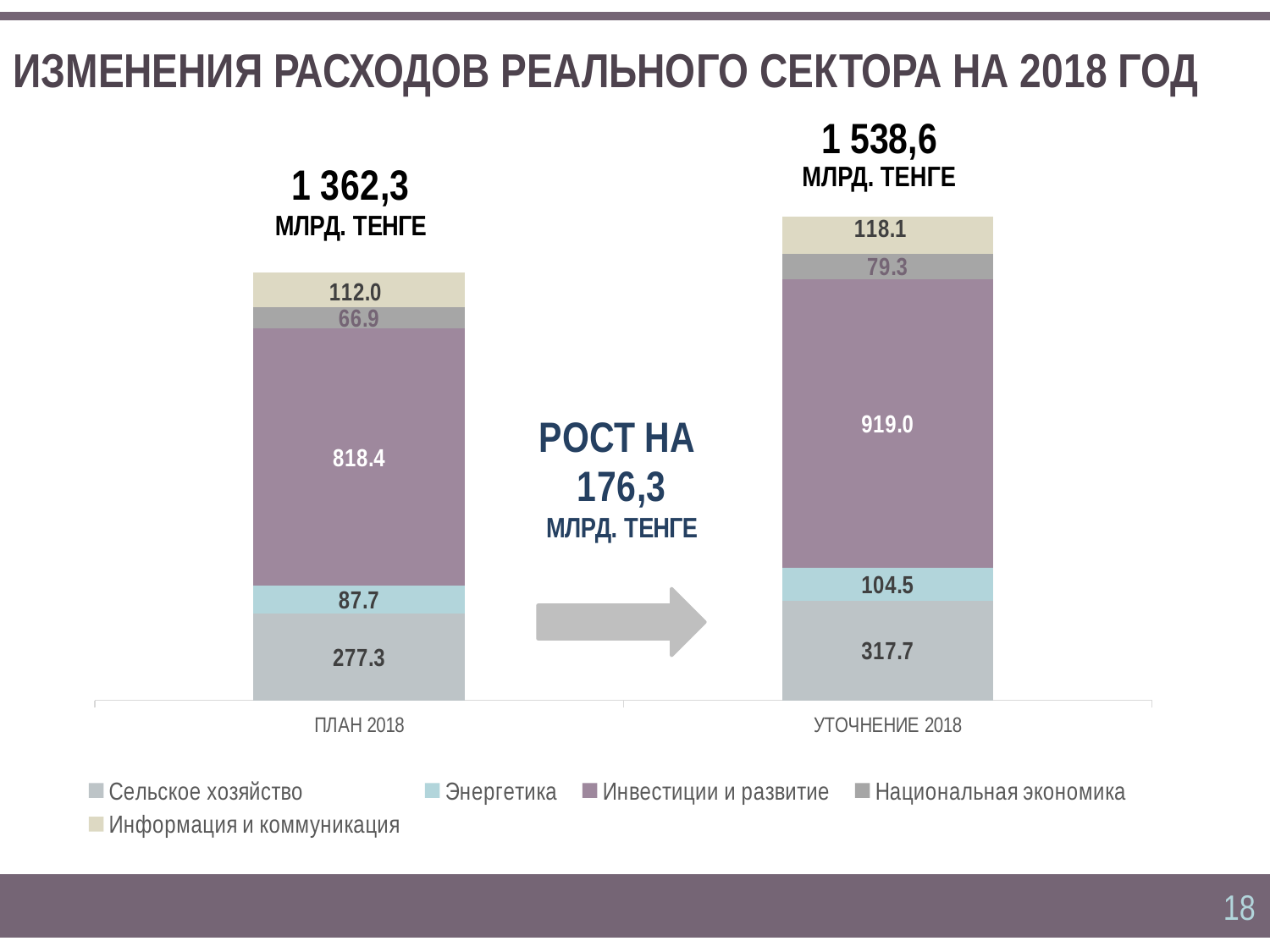
What is the value for Сельское хозяйство in УТОЧНЕНИЕ 2018? 317.7 Which series has the largest value in the ПЛАН 2018 bar? Инвестиции и развитие What is the total of the stacked bar for ПЛАН 2018? 1 362,3 млрд. тенге How many series does the legend list? 5 What type of chart is shown on the slide? Stacked bar chart What is the total of the stacked bar for УТОЧНЕНИЕ 2018? 1 538,6 млрд. тенге What is the value for Национальная экономика in УТОЧНЕНИЕ 2018? 79.3 What is the value for Инвестиции и развитие in ПЛАН 2018? 818.4 Which series has the smallest value in the УТОЧНЕНИЕ 2018 bar? Национальная экономика What is the value for Энергетика in ПЛАН 2018? 87.7 How many categories are shown on the x axis? 2 What is the difference between Инвестиции и развитие in УТОЧНЕНИЕ 2018 and in ПЛАН 2018? 100.6